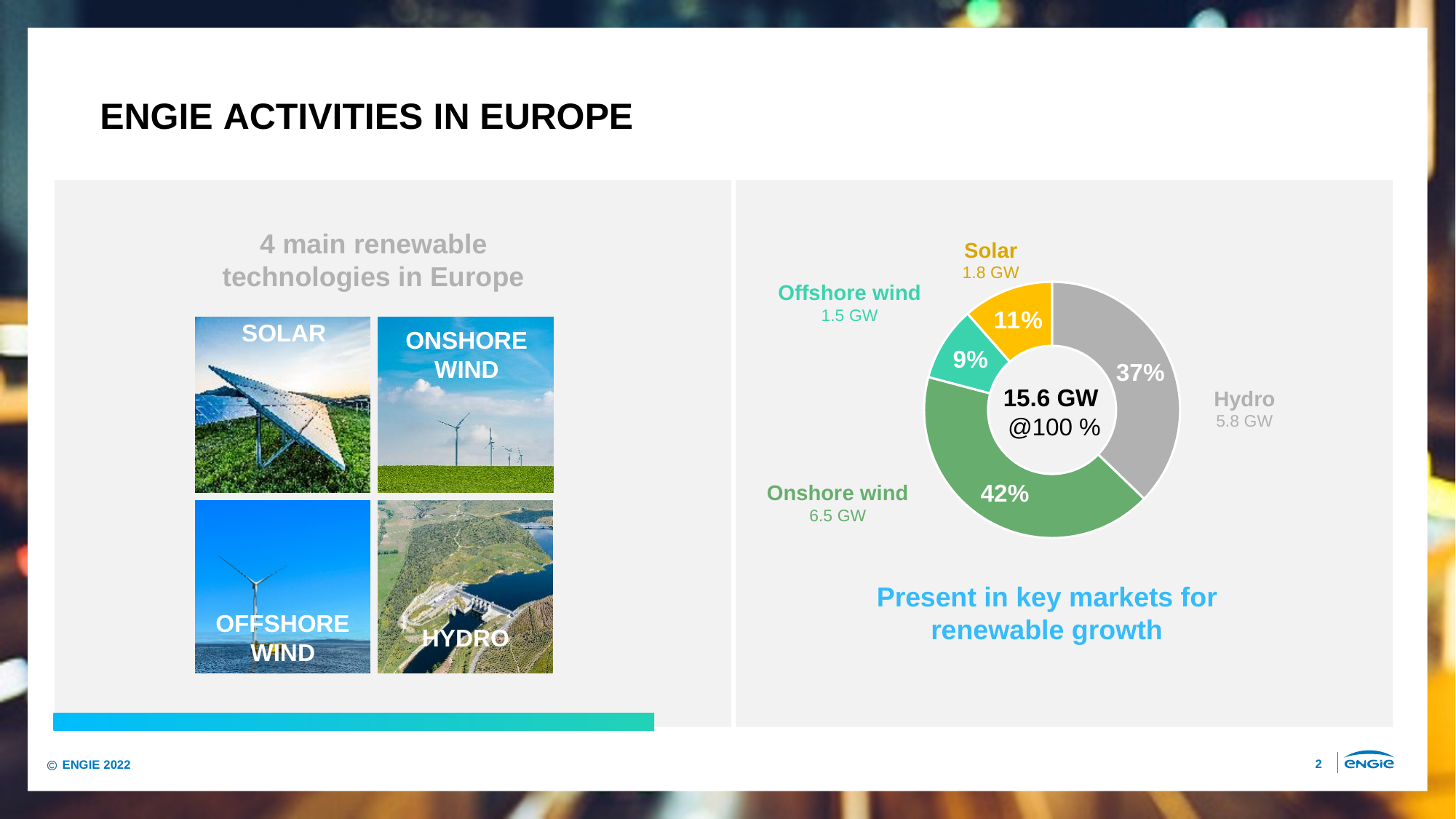
What share of the doughnut chart does Onshore wind represent? 42% What is the capacity shown for Solar in the doughnut chart? 1.8 GW Which category has the smallest share in the doughnut chart? Offshore wind Which category has the largest share in the doughnut chart? Onshore wind What is the difference in percentage points between the Onshore wind and Hydro shares? 5 What is the capacity shown for Offshore wind in the doughnut chart? 1.5 GW What share of the doughnut chart does Hydro represent? 37% What colour is the Hydro segment of the doughnut chart? Grey What total capacity is shown in the centre of the doughnut chart? 15.6 GW How many categories are shown in the doughnut chart? 4 What kind of chart is shown on the slide? Doughnut chart Which has a larger capacity, Solar or Offshore wind? Solar